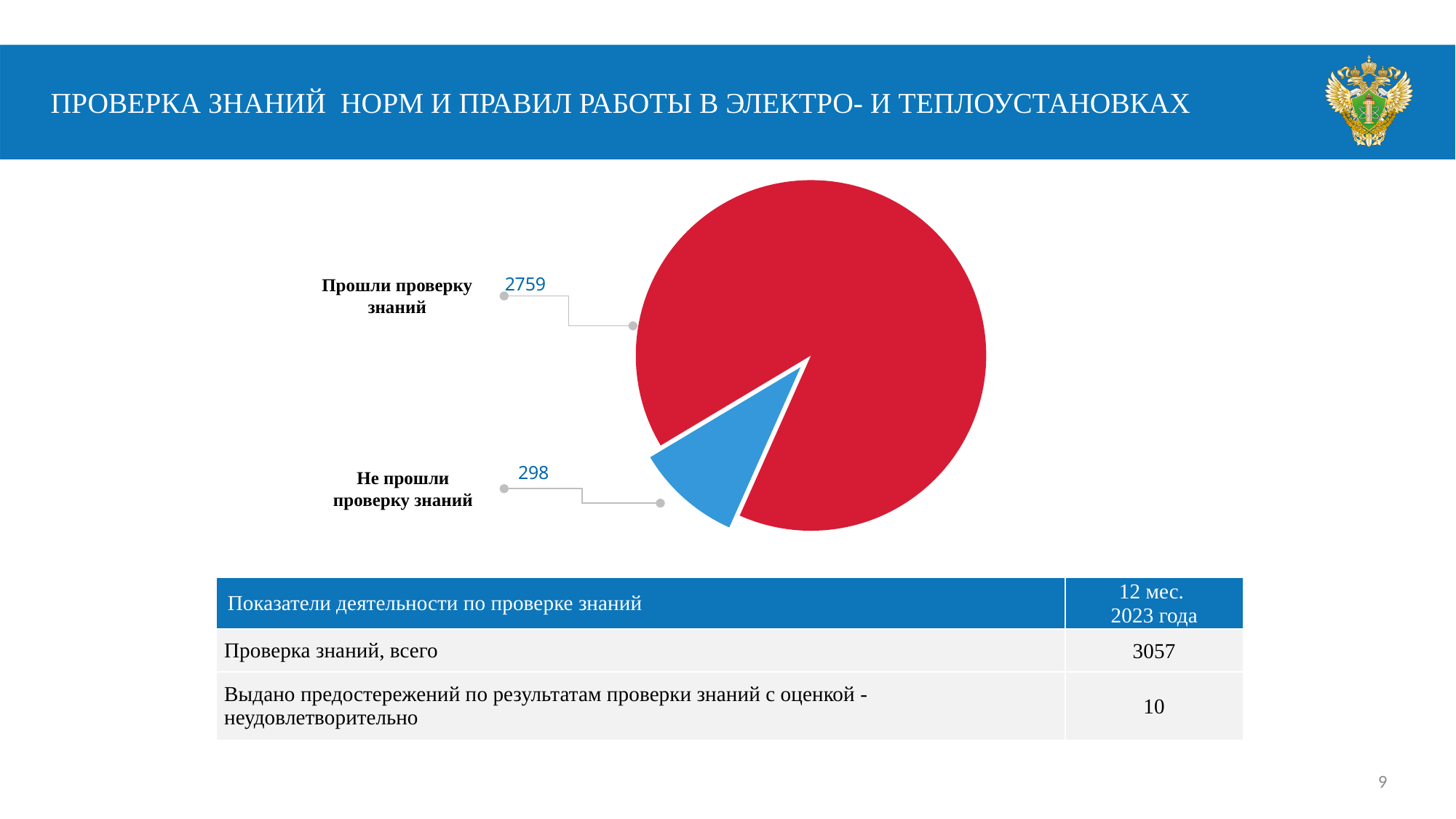
What is the total of the two values shown in the pie chart? 3057 What kind of chart is shown on the slide? pie chart What colour is the slice for "Прошли проверку знаний"? red How many slices does the pie chart have? 2 What is the difference between the values for "Прошли проверку знаний" and "Не прошли проверку знаний"? 2461 What is the value for "Не прошли проверку знаний" in the pie chart? 298 Which category has the smallest slice in the pie chart? Не прошли проверку знаний What share of the pie does "Не прошли проверку знаний" represent, to one decimal place? 9.7% Which is larger: the value for "Прошли проверку знаний" or for "Не прошли проверку знаний"? Прошли проверку знаний What is the value for "Прошли проверку знаний" in the pie chart? 2759 Which category has the largest slice in the pie chart? Прошли проверку знаний What colour is the slice for "Не прошли проверку знаний"? blue